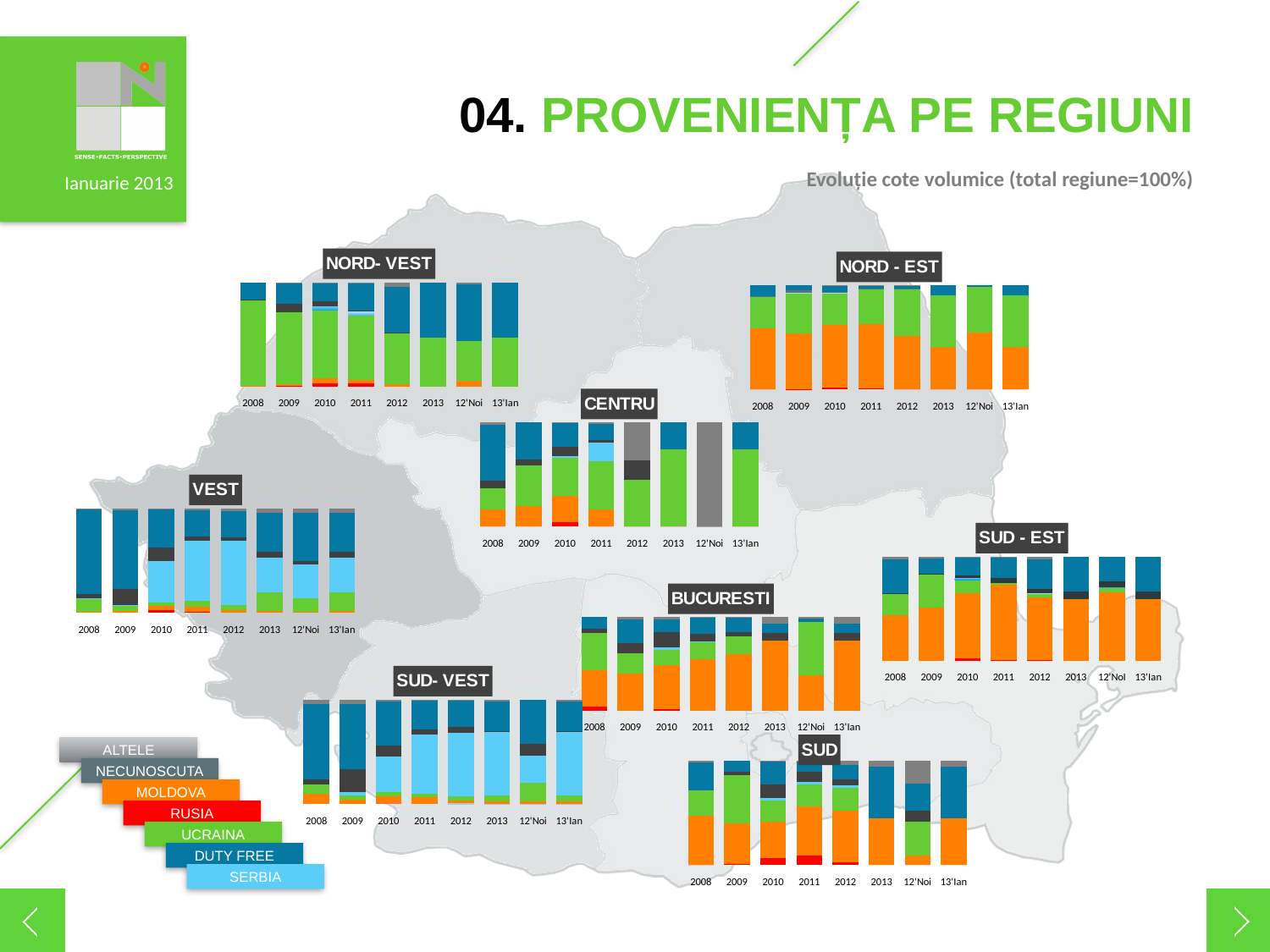
In the VEST chart, does the DUTY FREE share rise or fall from 2008 to 2013? Fall Which series is shown in light blue in the legend? SERBIA How many time periods (categories) are shown on the x axis of the NORD-VEST chart? 8 In the CENTRU chart, which series makes up the entire 12'Noi bar? ALTELE In the NORD-EST chart, which series has the largest share in 2013? UCRAINA In the VEST chart, which series has the largest share in 2008? DUTY FREE In the NORD-VEST chart, which is larger in 2013: the DUTY FREE share or the UCRAINA share? DUTY FREE In the BUCURESTI chart, which series has the largest share in 12'Noi? UCRAINA What is the subtitle describing what the charts show? Evoluție cote volumice (total regiune=100%) What kind of chart is used for each region on the slide? Stacked bar chart How many series does the legend at the bottom left of the slide list? 7 In the SUD-VEST chart, does the SERBIA share rise or fall from 2008 to 2013? Rise